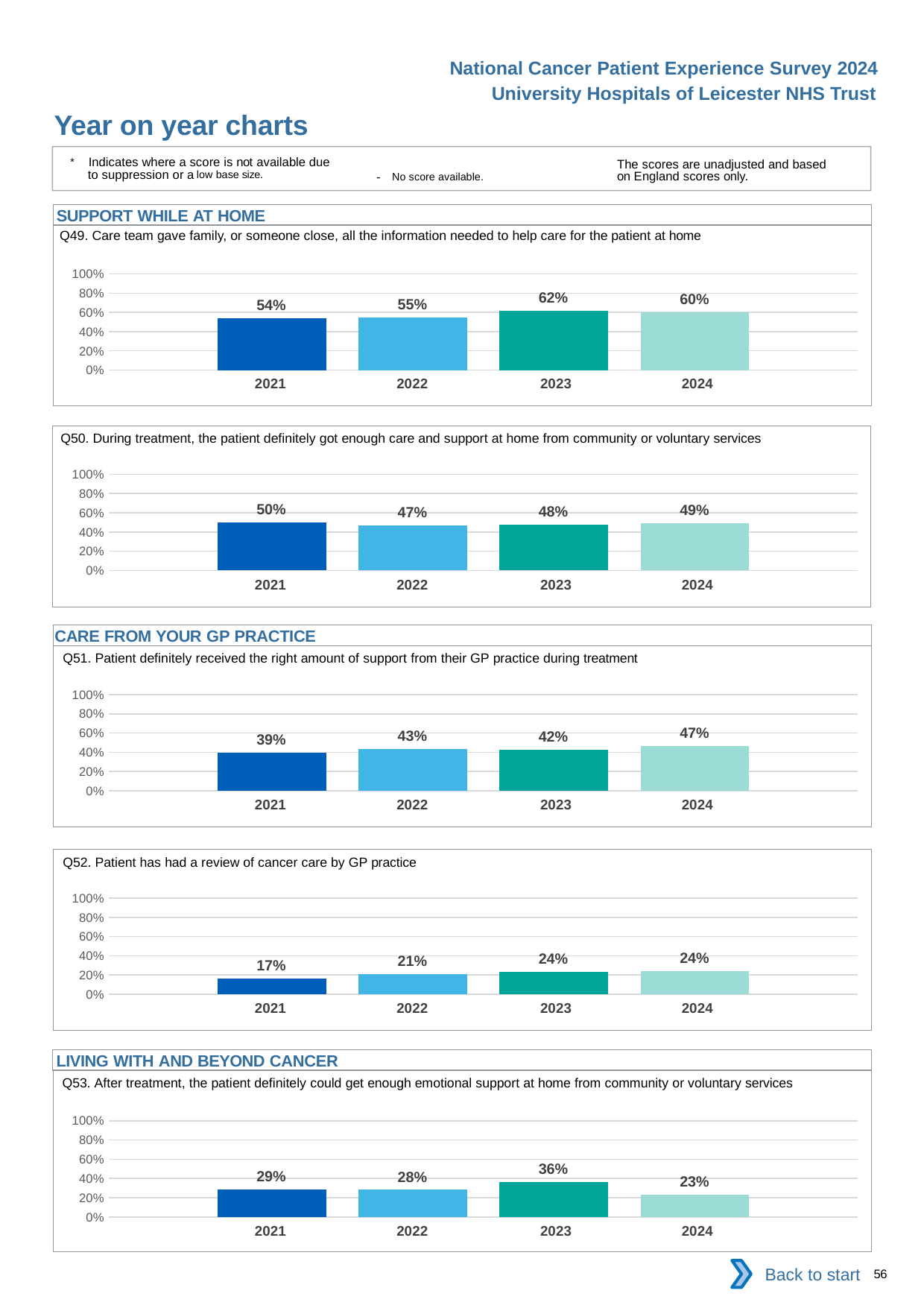
In the Q50 chart, what is the value for 2022? 47% In the Q51 chart, which year has the highest value? 2024 In the Q52 chart, is the value for 2022 greater or less than 40%? less In the Q53 chart, which is larger, the value for 2023 or the value for 2024? 2023 In the Q49 chart, what is the value for 2023? 62% In the Q49 chart, which year has the lowest value? 2021 What kind of chart is the Q49 chart? Bar chart In the Q53 chart, what is the difference between the 2023 and 2024 values? 13% In the Q52 chart, what is the value for 2021? 17% In the Q50 chart, which year has the highest value? 2021 How many years are shown in the Q52 chart? 4 In the Q51 chart, what is the difference between the 2024 and 2021 values? 8%